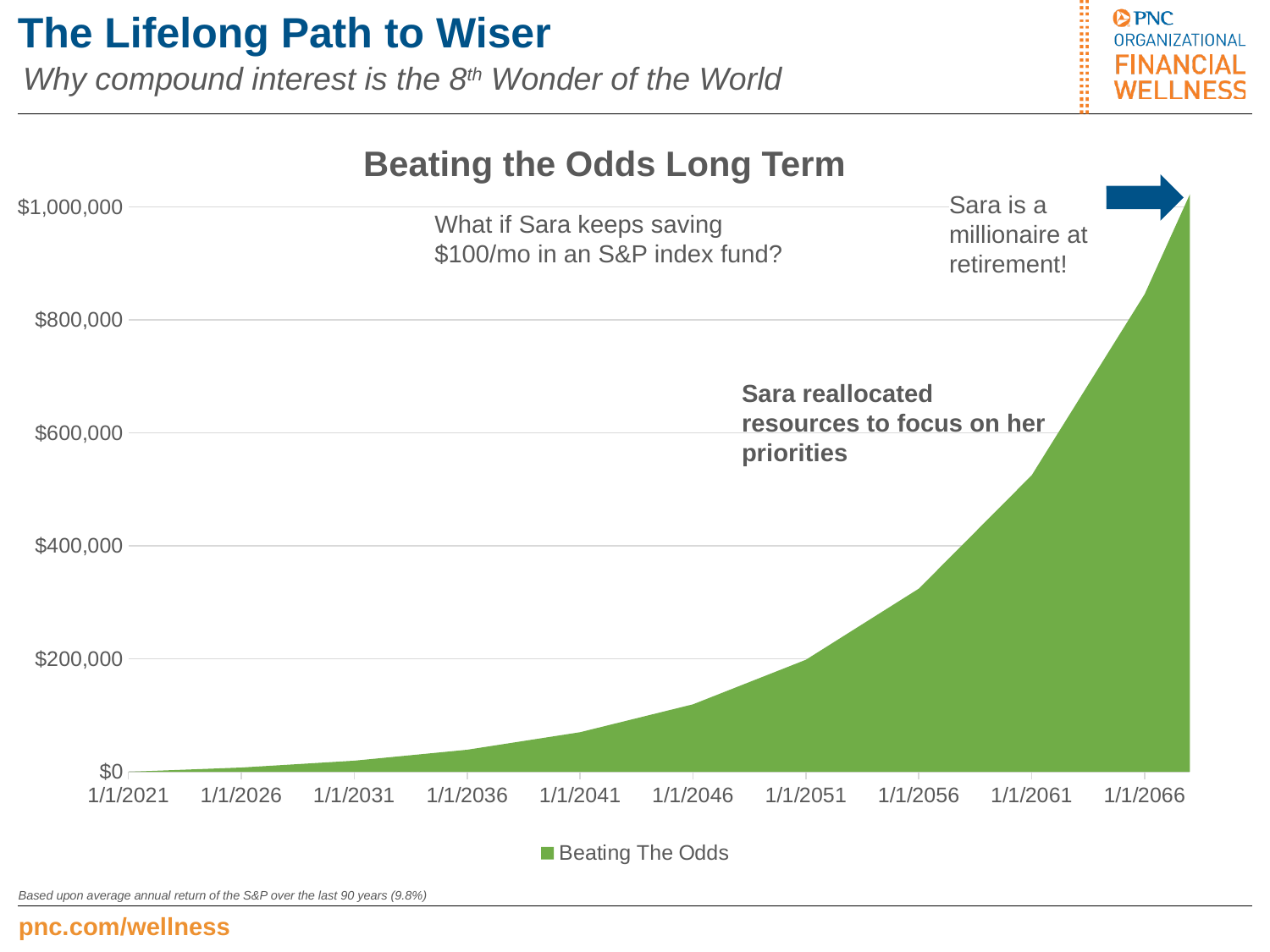
How many series does the chart legend list? 1 What is the title of the chart? Beating the Odds Long Term Is the value at 1/1/2061 greater or less than $400,000? greater Which is larger, the value at 1/1/2041 or the value at 1/1/2056? 1/1/2056 Is the value at 1/1/2061 greater or less than $600,000? less At which x-axis date is the chart's value lowest? 1/1/2021 What is the name of the series shown in the chart legend? Beating The Odds What kind of chart is shown on the slide? area chart Do the values rise or fall along the x axis from 1/1/2021 to 1/1/2066? rise Is the value at 1/1/2056 greater or less than $200,000? greater